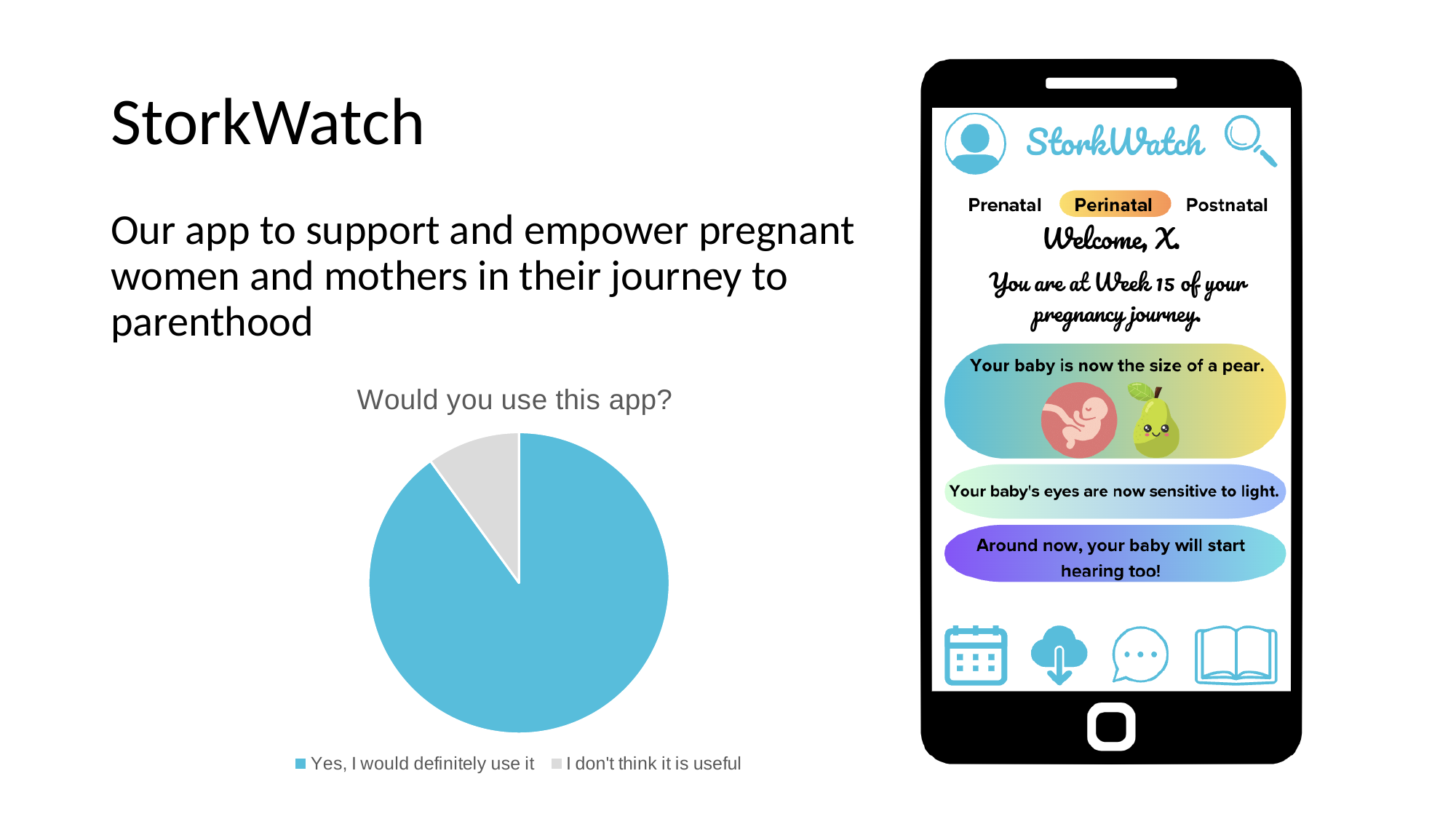
What colour is the "I don't think it is useful" slice in the pie chart? Grey How many slices does the pie chart have? 2 Which response has the smallest slice in the pie chart? I don't think it is useful In the pie chart, which slice is larger: "Yes, I would definitely use it" or "I don't think it is useful"? Yes, I would definitely use it Which response has the largest slice in the pie chart? Yes, I would definitely use it What is the title of the pie chart? Would you use this app? What kind of chart is shown under the heading "Would you use this app?"? Pie chart How many entries does the pie chart's legend list? 2